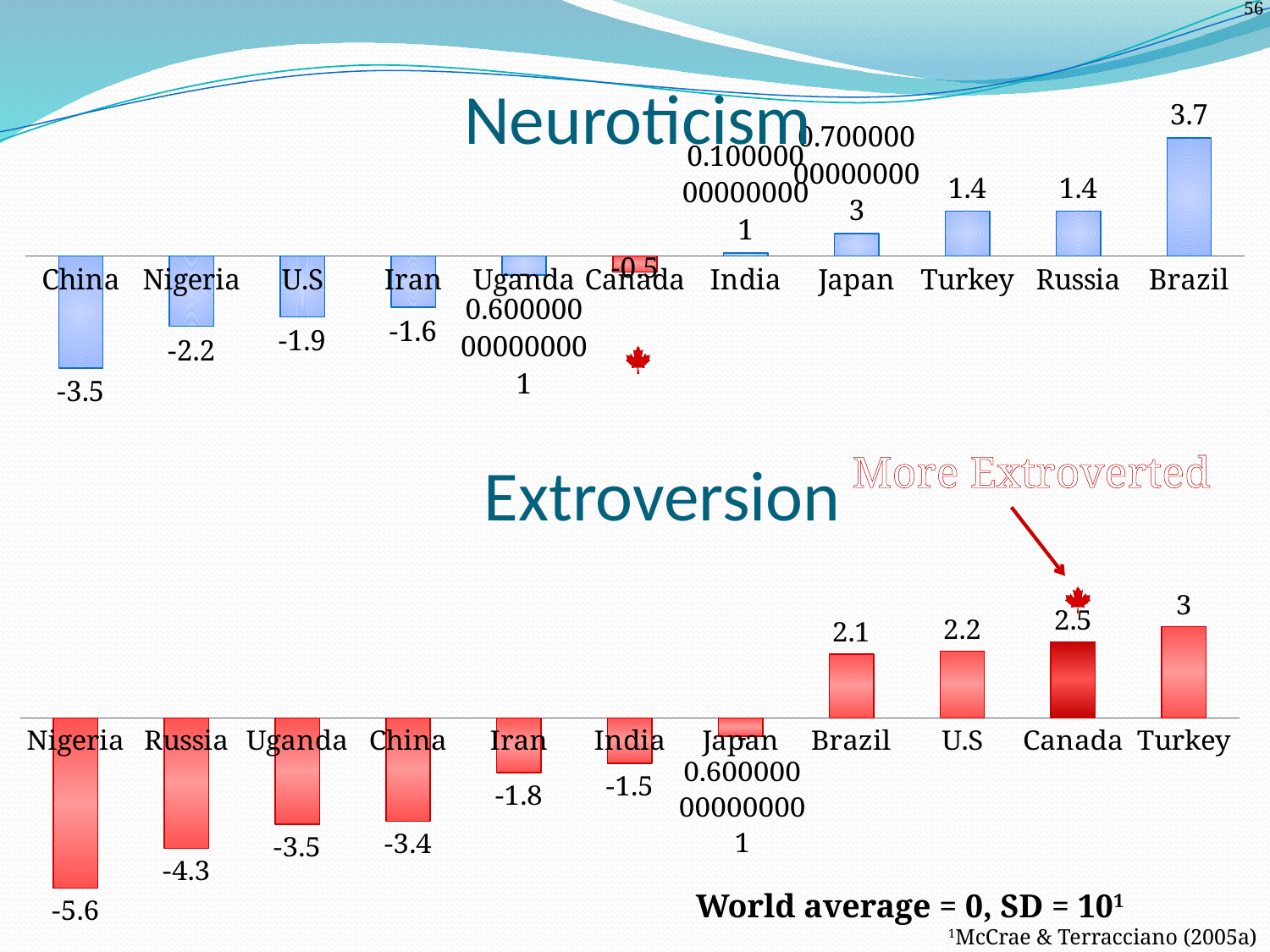
In the Neuroticism chart, which country has the highest value? Brazil In the Extroversion chart, what is the value for Nigeria? -5.6 In the Extroversion chart, what is the value for Canada? 2.5 In the Neuroticism chart, how many countries are shown? 11 What kind of chart is the Extroversion chart? bar chart In the Neuroticism chart, what is the value for Brazil? 3.7 In the Extroversion chart, which country has the lowest value? Nigeria In the Extroversion chart, which is larger, the value for Canada or the value for U.S? Canada In the Extroversion chart, which country has the highest value? Turkey In the Neuroticism chart, what is the difference between the values for Brazil and Turkey? 2.3 In the Neuroticism chart, what is the value for China? -3.5 In the Neuroticism chart, which country has the lowest value? China